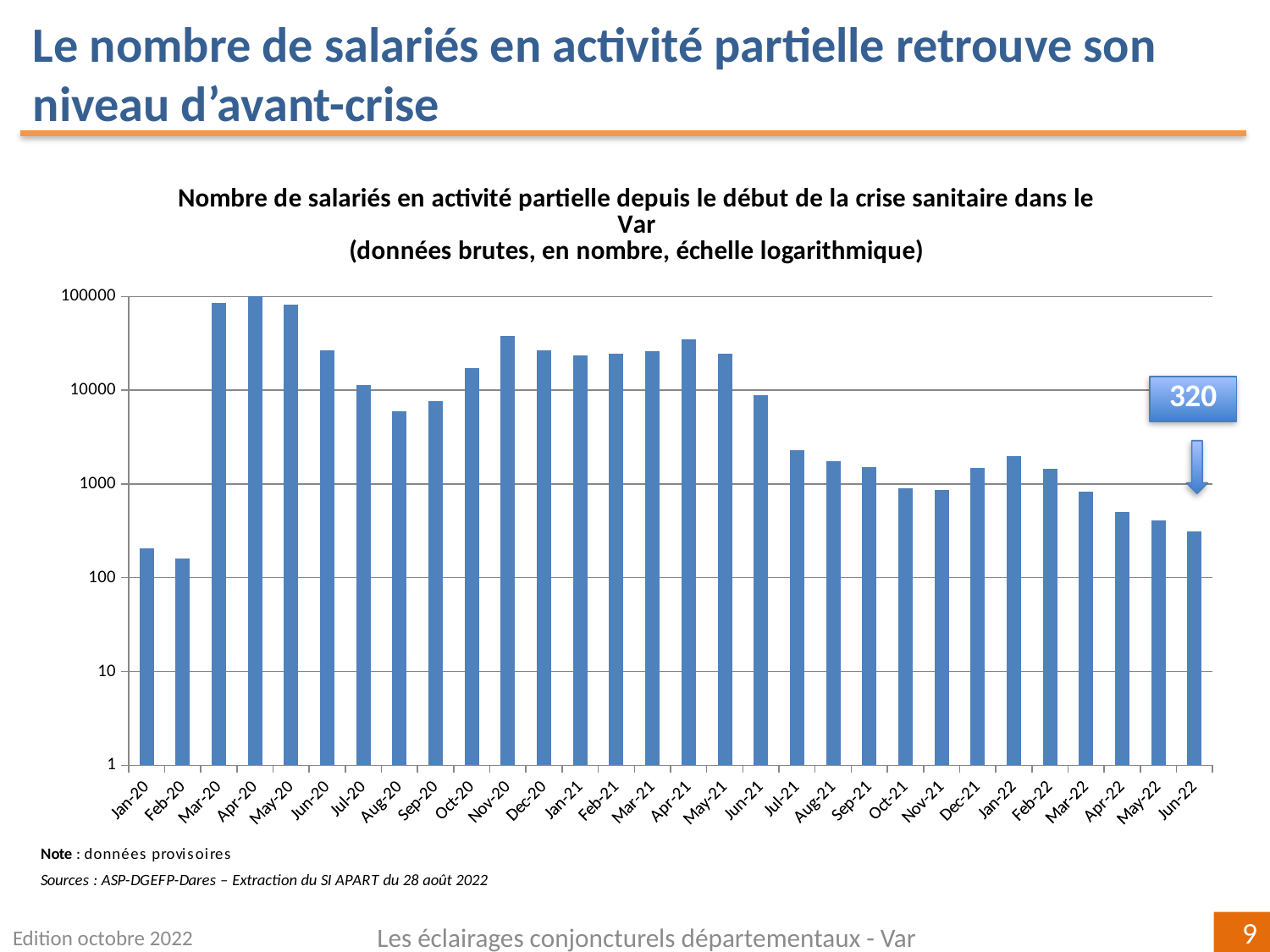
Is the value for Jan-20 greater or less than 100? greater Do the values rise or fall from Jan-22 to Jun-22? Fall Is the value for Nov-20 greater or less than 10000? greater Which month has the lowest number of employees in partial activity? Feb-20 Is the value for Jul-21 greater or less than 1000? greater Which month has the highest number of employees in partial activity? Apr-20 What kind of chart is shown on the slide? Bar chart Which is larger, the value for Nov-20 or the value for Dec-20? Nov-20 How many months are plotted on the x axis? 30 What value is printed in the callout for Jun-22? 320 Which is larger, the value for May-22 or the value for Jun-22? May-22